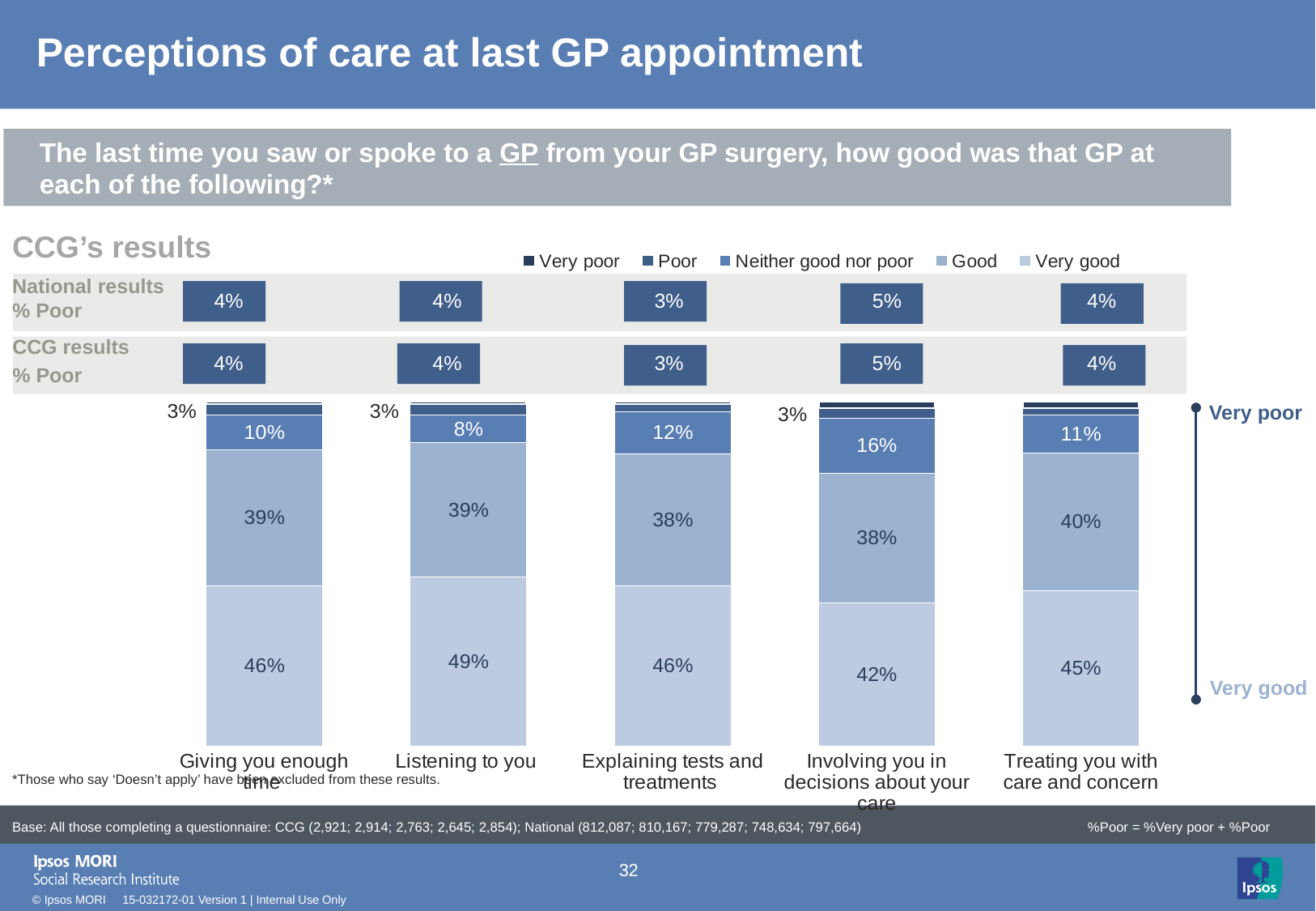
What is the 'Neither good nor poor' value for 'Involving you in decisions about your care'? 16% What kind of chart is shown on the slide? stacked bar chart What is the 'Very good' value for 'Listening to you'? 49% Which is larger: the 'Neither good nor poor' value for 'Explaining tests and treatments' or for 'Listening to you'? Explaining tests and treatments What is the National results '% Poor' value for 'Explaining tests and treatments'? 3% Which category has the highest 'Very good' value? Listening to you How many categories are plotted along the x axis of the stacked bar chart? 5 How many series does the legend list? 5 What is the CCG results '% Poor' value for 'Involving you in decisions about your care'? 5% What is the difference between the 'Very good' values for 'Listening to you' and 'Involving you in decisions about your care'? 7% What is the 'Good' value for 'Treating you with care and concern'? 40% Which category has the lowest 'Very good' value? Involving you in decisions about your care